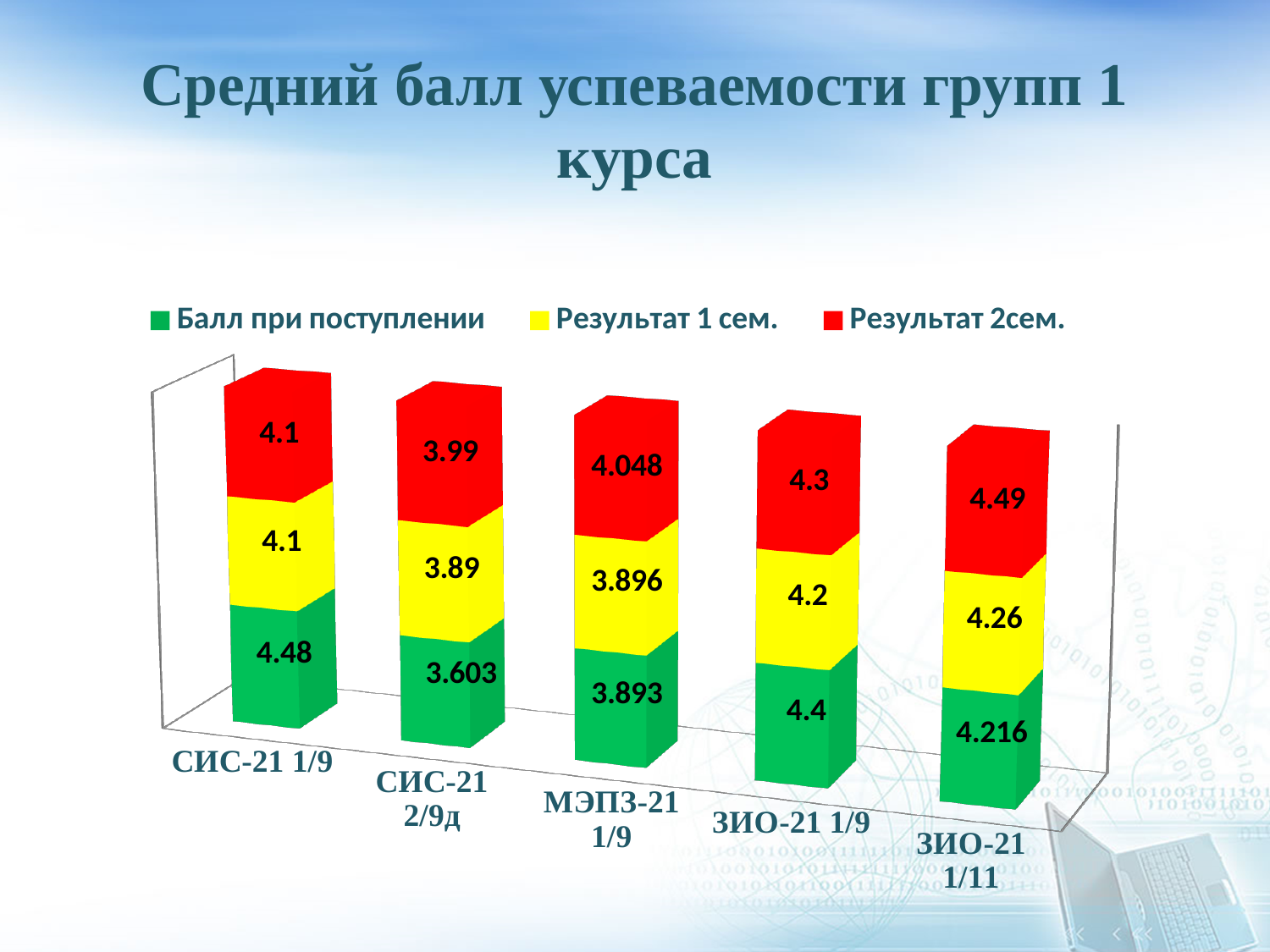
Which colour represents "Результат 1 сем." in the chart? Yellow What is the value of "Балл при поступлении" for СИС-21 2/9д? 3.603 What is the value of "Результат 2сем." for ЗИО-21 1/11? 4.49 How many series does the legend list? 3 What is the difference between the "Результат 2сем." values for ЗИО-21 1/11 and СИС-21 2/9д? 0.5 How many groups are shown on the x axis? 5 What kind of chart is shown on the slide? Stacked bar chart Which is larger: the "Балл при поступлении" value for СИС-21 1/9 or for ЗИО-21 1/9? СИС-21 1/9 What is the value of "Результат 1 сем." for МЭПЗ-21 1/9? 3.896 Which group has the lowest value for "Балл при поступлении"? СИС-21 2/9д What is the total of the stacked bar for ЗИО-21 1/9? 12.9 Which group has the highest value for "Результат 2сем."? ЗИО-21 1/11